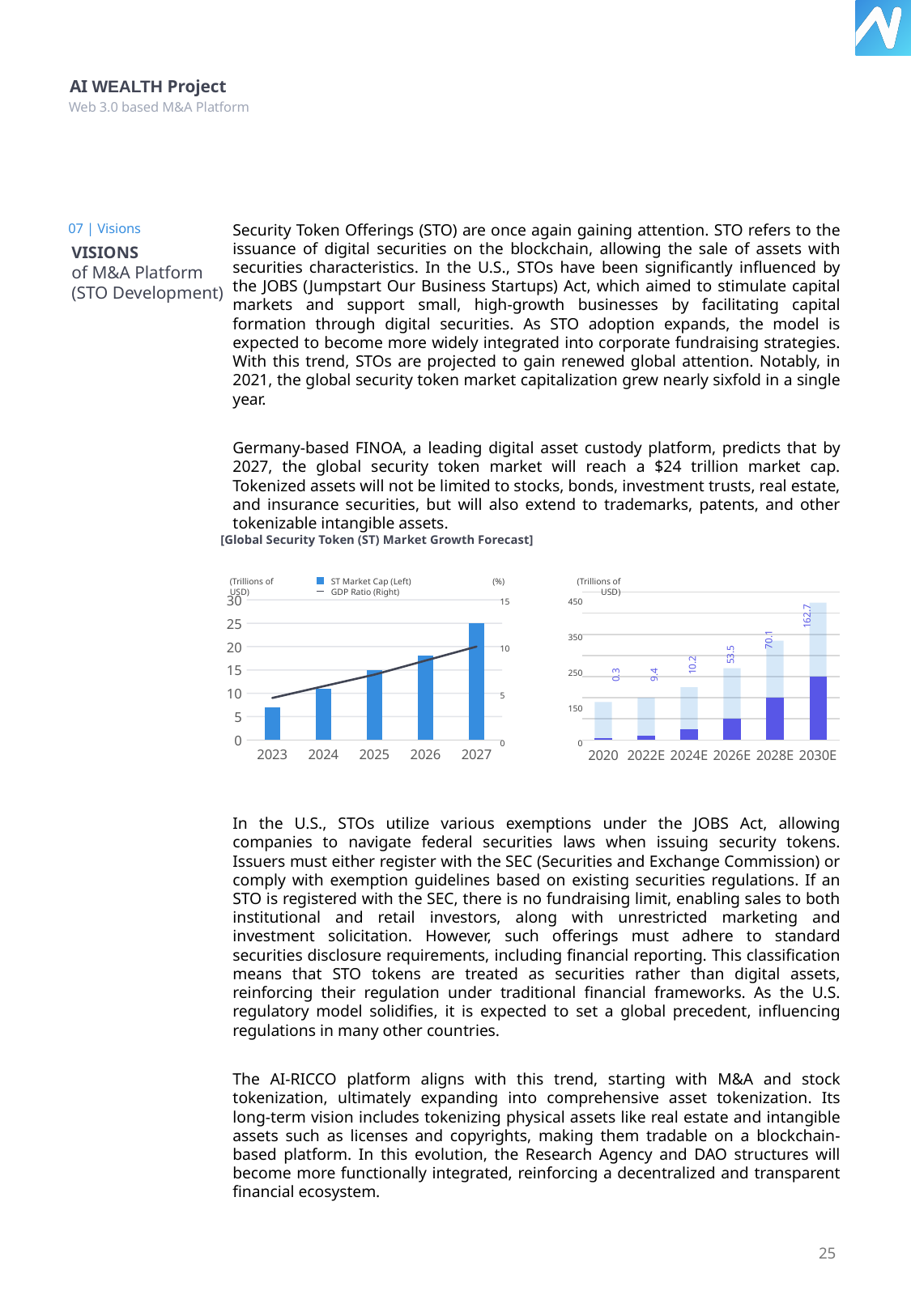
In the right chart, what data label is shown for 2026E? 53.5 In the left chart, which year has the lowest ST Market Cap bar? 2023 In the right chart, what data label is shown for 2030E? 162.7 In the left chart (ST Market Cap and GDP Ratio), how many years are shown on the x axis? 5 In the left chart, which year has the highest ST Market Cap bar? 2027 In the left chart, is the ST Market Cap value for 2027 greater or less than 20? greater In the right chart, how many years are shown on the x axis? 6 In the left chart, do the ST Market Cap bars rise or fall from 2023 to 2027? rise In the right chart, what is the difference between the labelled values for 2030E and 2028E? 92.6 What type of chart is the right-hand chart under the Global Security Token (ST) Market Growth Forecast heading? bar chart In the left chart, is the ST Market Cap value for 2023 greater or less than 10? less How many series does the legend of the left chart list? 2